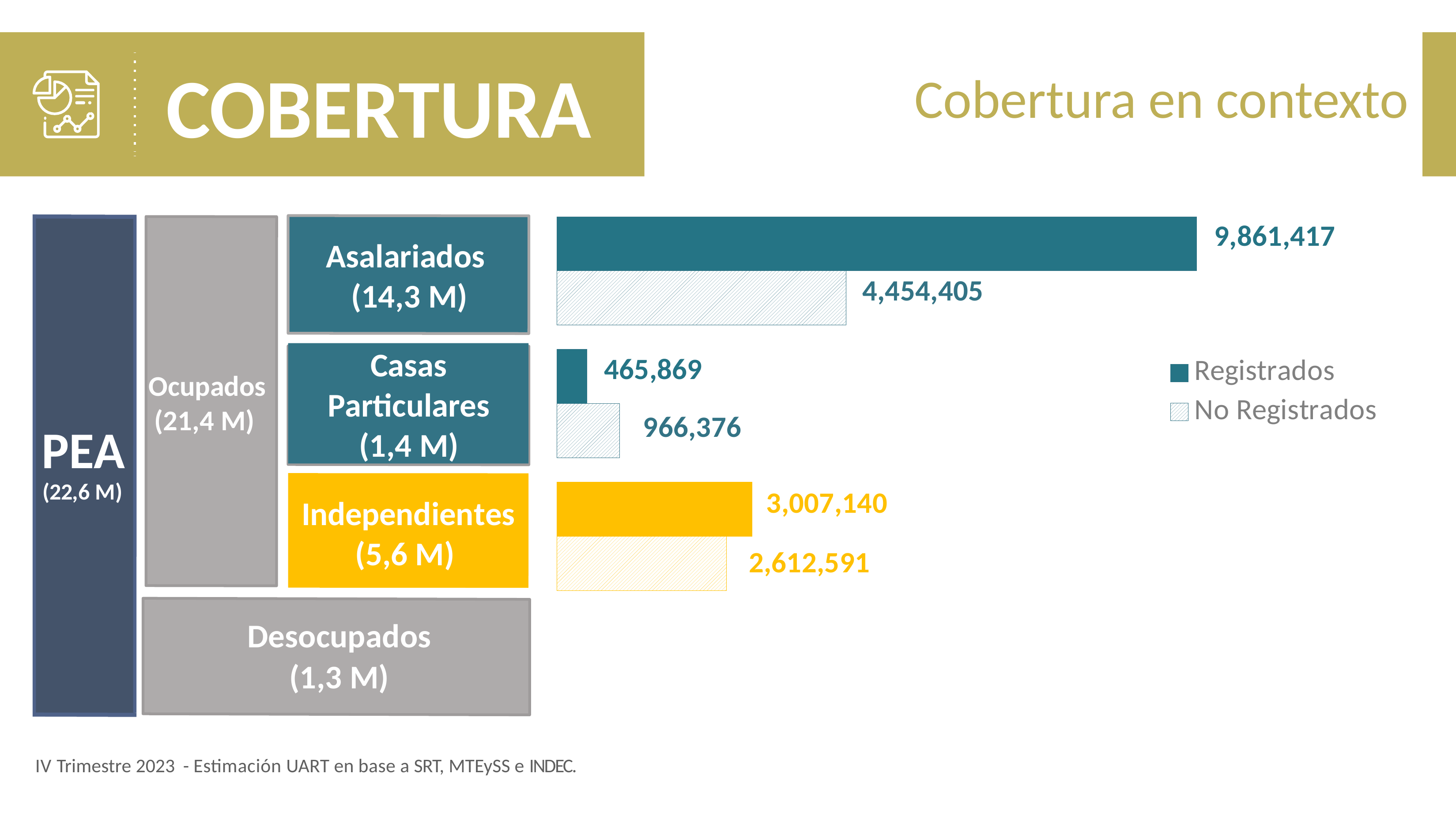
What is the Registrados value for Casas Particulares? 465,869 What is the No Registrados value for Independientes? 2,612,591 What is the difference between the Registrados and No Registrados values for Asalariados? 5,407,012 What is the No Registrados value for Asalariados? 4,454,405 What is the Registrados value for Independientes? 3,007,140 What is the No Registrados value for Casas Particulares? 966,376 How many series does the legend list? 2 What is the Registrados value for Asalariados? 9,861,417 Which category has the lowest No Registrados value? Casas Particulares For Casas Particulares, which is larger: Registrados or No Registrados? No Registrados What kind of chart is shown on the slide? Bar chart Which category has the highest Registrados value? Asalariados